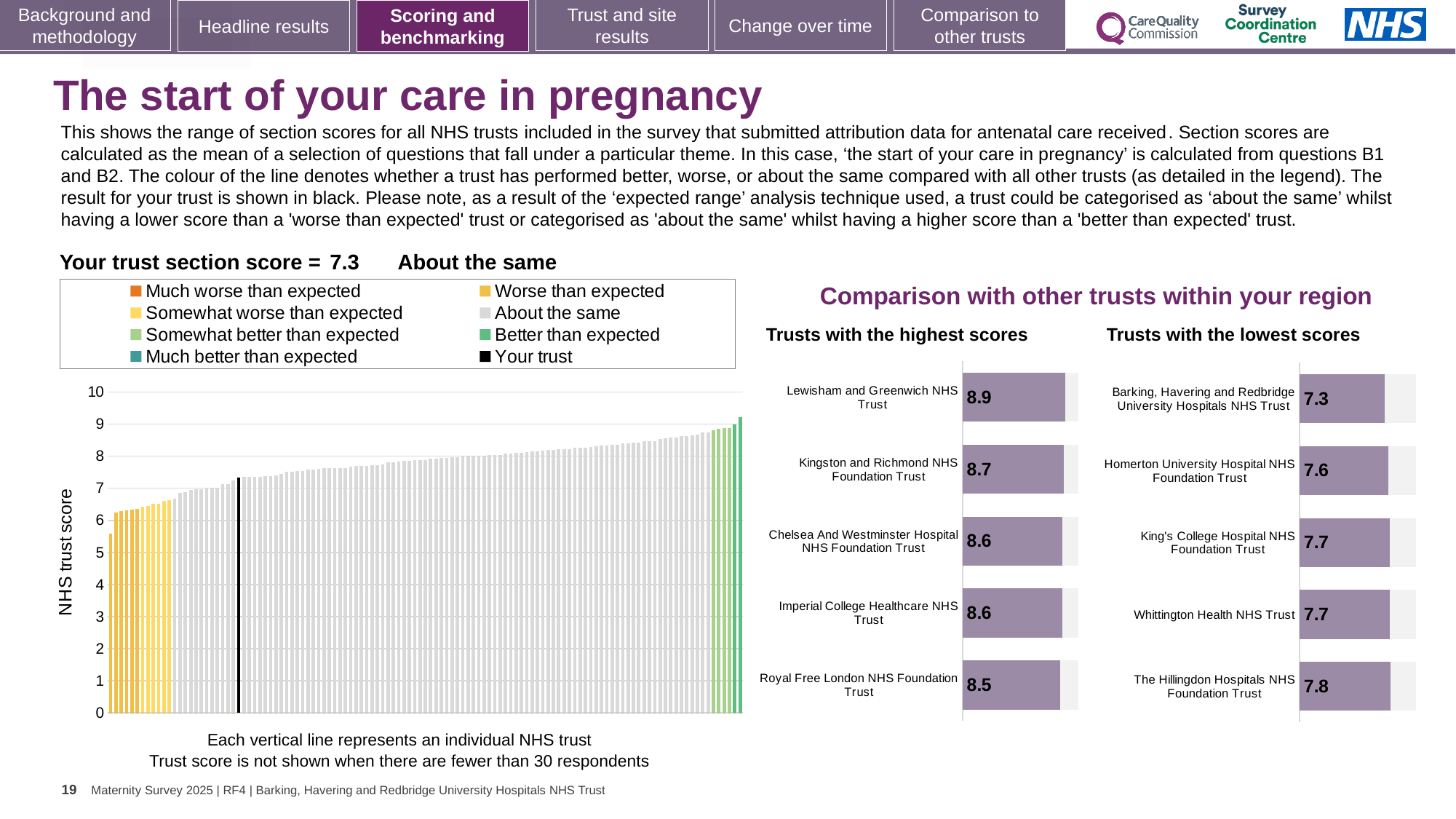
In the 'Trusts with the lowest scores' chart, which has the higher score: Homerton University Hospital NHS Foundation Trust or King's College Hospital NHS Foundation Trust? King's College Hospital NHS Foundation Trust In the 'Trusts with the highest scores' chart, which trust has the highest score? Lewisham and Greenwich NHS Trust In the 'Trusts with the lowest scores' chart, which trust has the lowest score? Barking, Havering and Redbridge University Hospitals NHS Trust In the main 'NHS trust score' chart on the left, do the values rise or fall from left to right? rise In the 'Trusts with the lowest scores' chart, what is the difference between the scores of The Hillingdon Hospitals NHS Foundation Trust and Barking, Havering and Redbridge University Hospitals NHS Trust? 0.5 In the 'Trusts with the highest scores' chart, what is the score for Lewisham and Greenwich NHS Trust? 8.9 How many trusts are listed in the 'Trusts with the highest scores' chart? 5 What kind of chart is the main 'NHS trust score' chart on the left? bar chart In the 'Trusts with the lowest scores' chart, what is the score for Homerton University Hospital NHS Foundation Trust? 7.6 In the 'Trusts with the highest scores' chart, what is the score for Royal Free London NHS Foundation Trust? 8.5 In the 'Trusts with the highest scores' chart, what is the difference between the scores of Lewisham and Greenwich NHS Trust and Royal Free London NHS Foundation Trust? 0.4 In the main 'NHS trust score' chart on the left, is the value of the highest bar greater or less than 9? greater